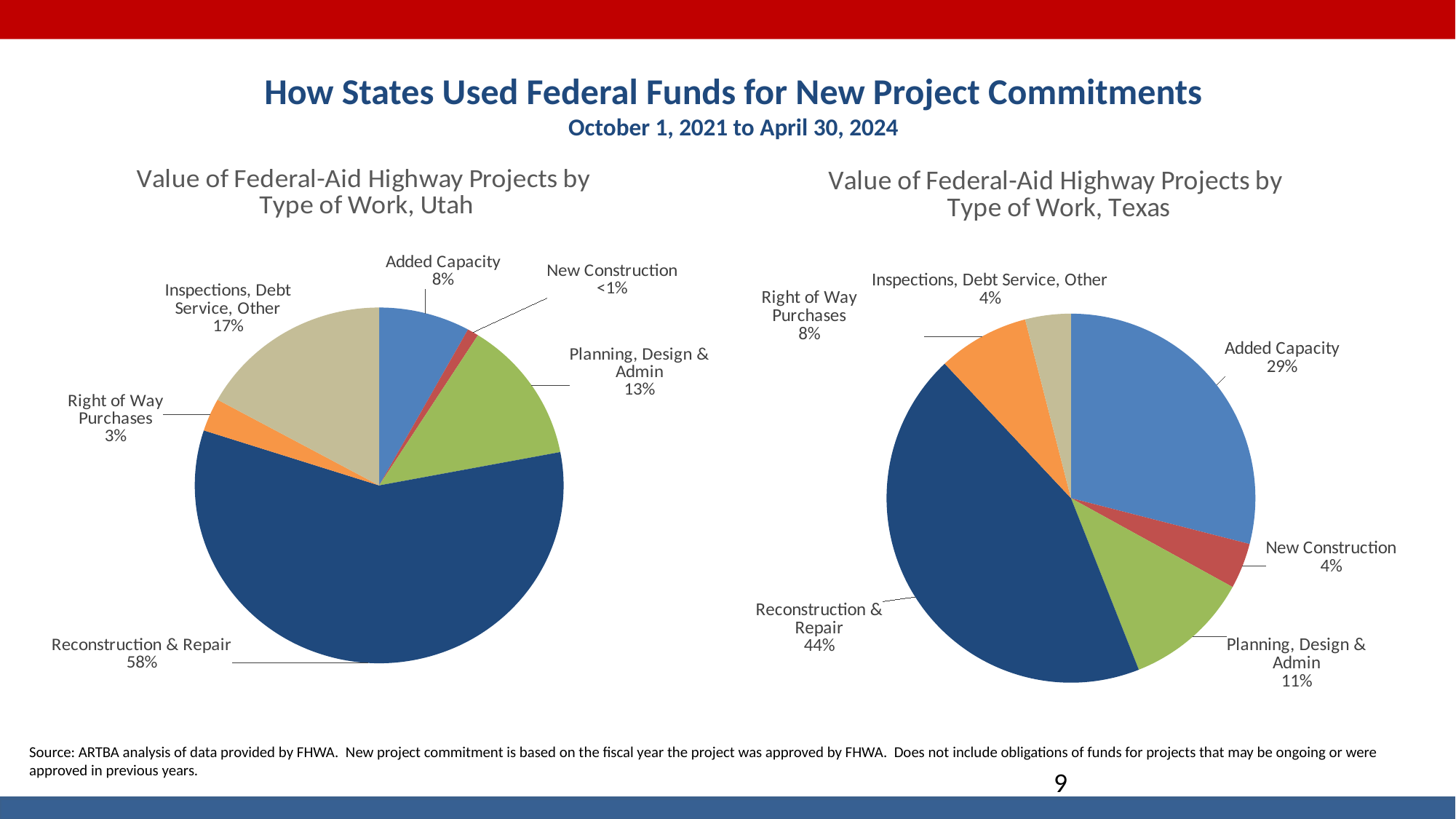
Which chart shows a larger share for Added Capacity, Utah or Texas? Texas What kind of chart is used on this slide to show the value of Federal-Aid Highway Projects by type of work? Pie chart What is the title of the chart on the right side of the slide? Value of Federal-Aid Highway Projects by Type of Work, Texas In the Texas pie chart, what is the difference between the Reconstruction & Repair share and the Added Capacity share? 15% In the Utah pie chart, what is the difference between the Inspections, Debt Service, Other share and the Planning, Design & Admin share? 4% In the Utah pie chart, which type of work has the smallest share? New Construction In the Utah pie chart, which type of work has the largest share? Reconstruction & Repair How many slices does the Utah pie chart have? 6 In the Texas pie chart, what share is Added Capacity? 29% In the Texas pie chart, which type of work has the largest share? Reconstruction & Repair Which is larger in the Texas pie chart: Right of Way Purchases or New Construction? Right of Way Purchases In the Utah pie chart, what share of the value of Federal-Aid Highway Projects is Reconstruction & Repair? 58%